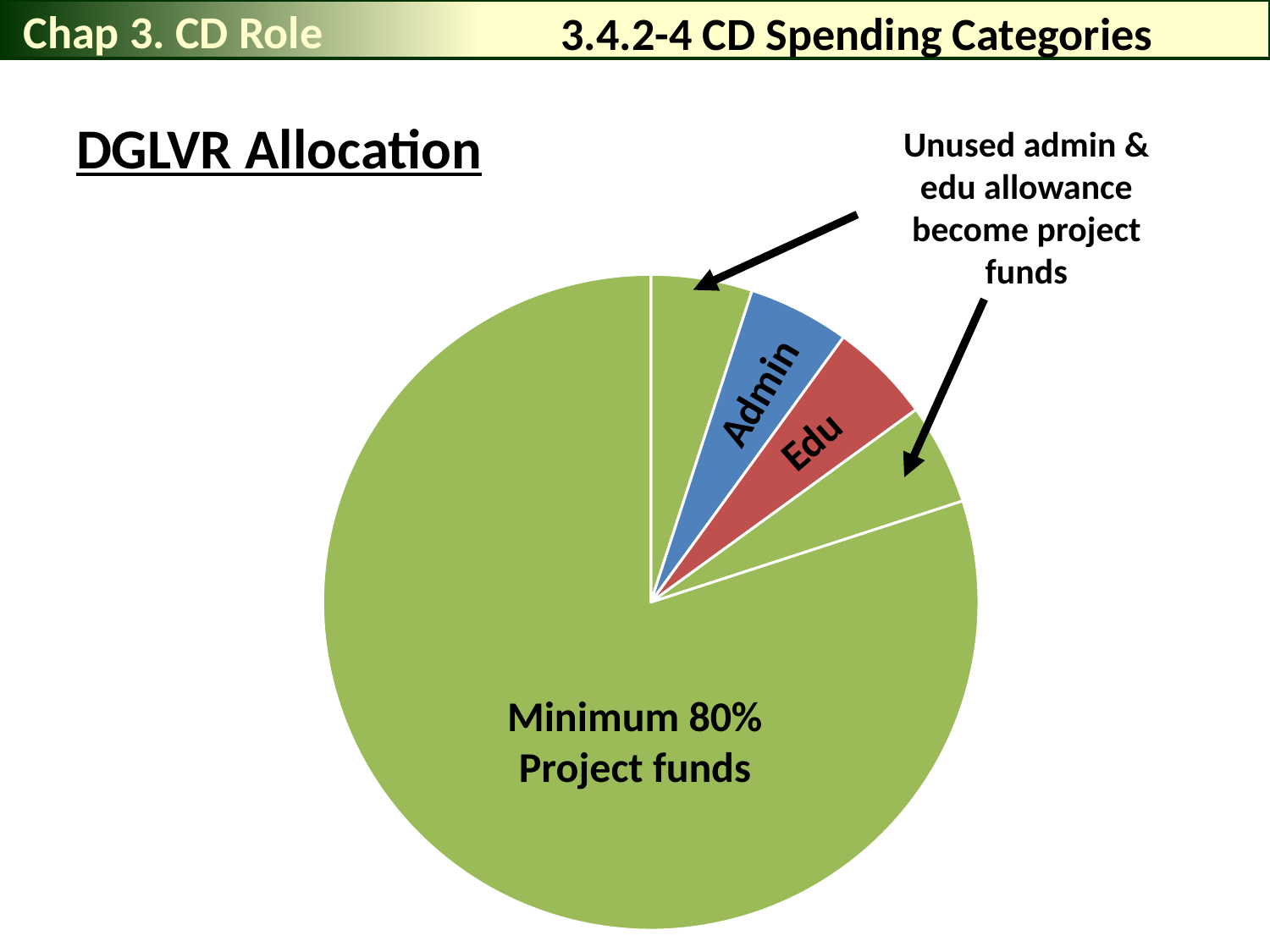
Is the share for Admin greater or less than 50%? less Is the share for Project funds greater or less than 50%? greater Which slice is shown in red? Edu According to the annotation, what happens to unused admin and edu allowance? become project funds What kind of chart is shown on the slide? pie chart How many slices does the pie chart have? 5 What share of the DGLVR allocation is labelled for project funds? Minimum 80% Which slice of the pie chart is the largest? Minimum 80% Project funds What is the title of the chart on the slide? DGLVR Allocation What colour is the Admin slice of the pie chart? blue Which is larger, the Project funds slice or the Edu slice? Project funds